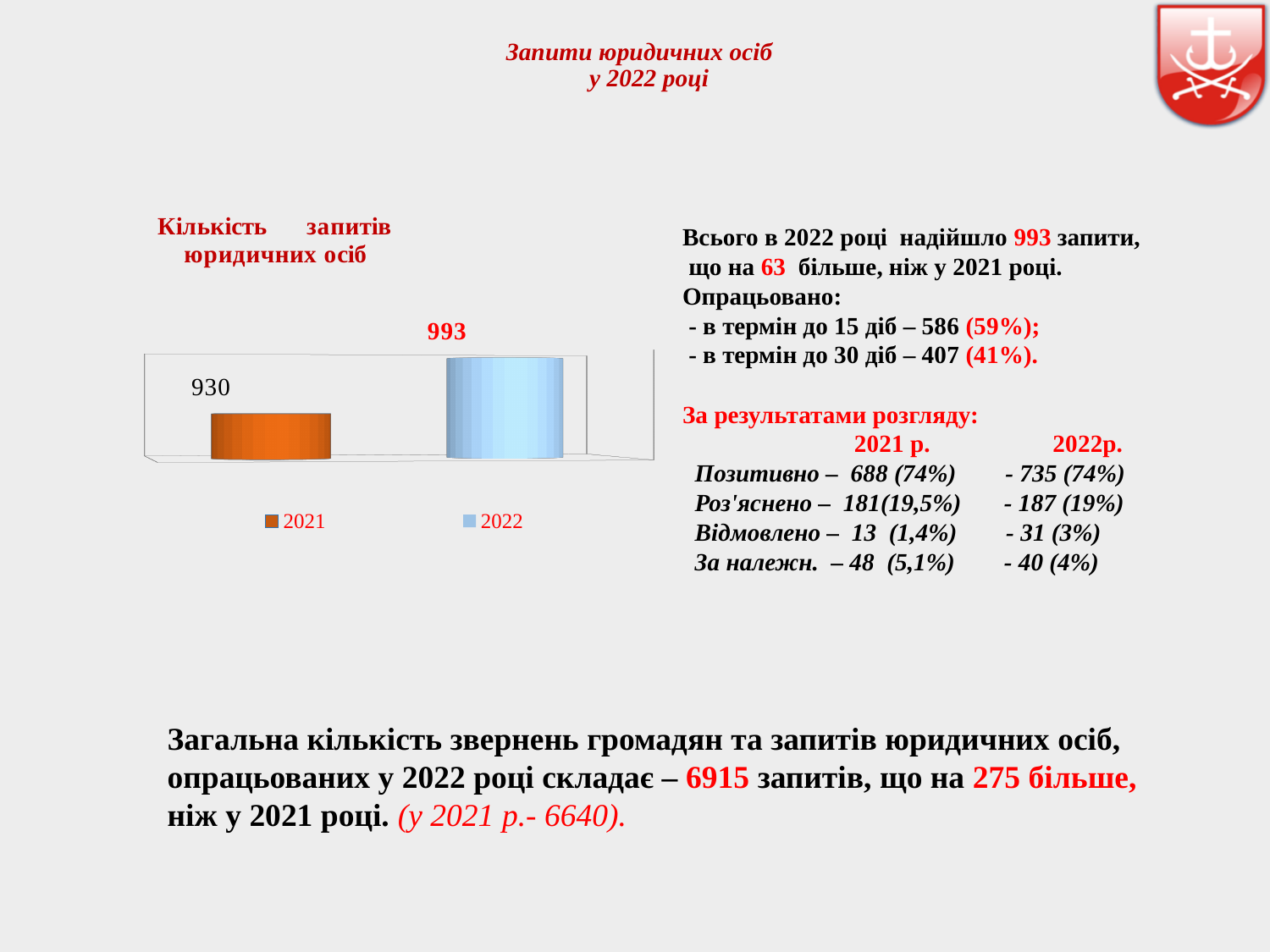
What is the title of the chart? Кількість запитів юридичних осіб Is the value for 2022 larger than the value for 2021? Yes How many bars are plotted in the chart? 2 What is the value for 2021 in the chart? 930 What is the value for 2022 in the chart? 993 What colour is the bar for 2021 in the chart? Orange What kind of chart is shown on the slide? Bar chart Which year has the higher value in the chart? 2022 Which year has the lower value in the chart? 2021 What is the difference between the 2022 and 2021 values in the chart? 63 Do the values rise or fall from 2021 to 2022 in the chart? Rise How many entries does the chart legend list? 2